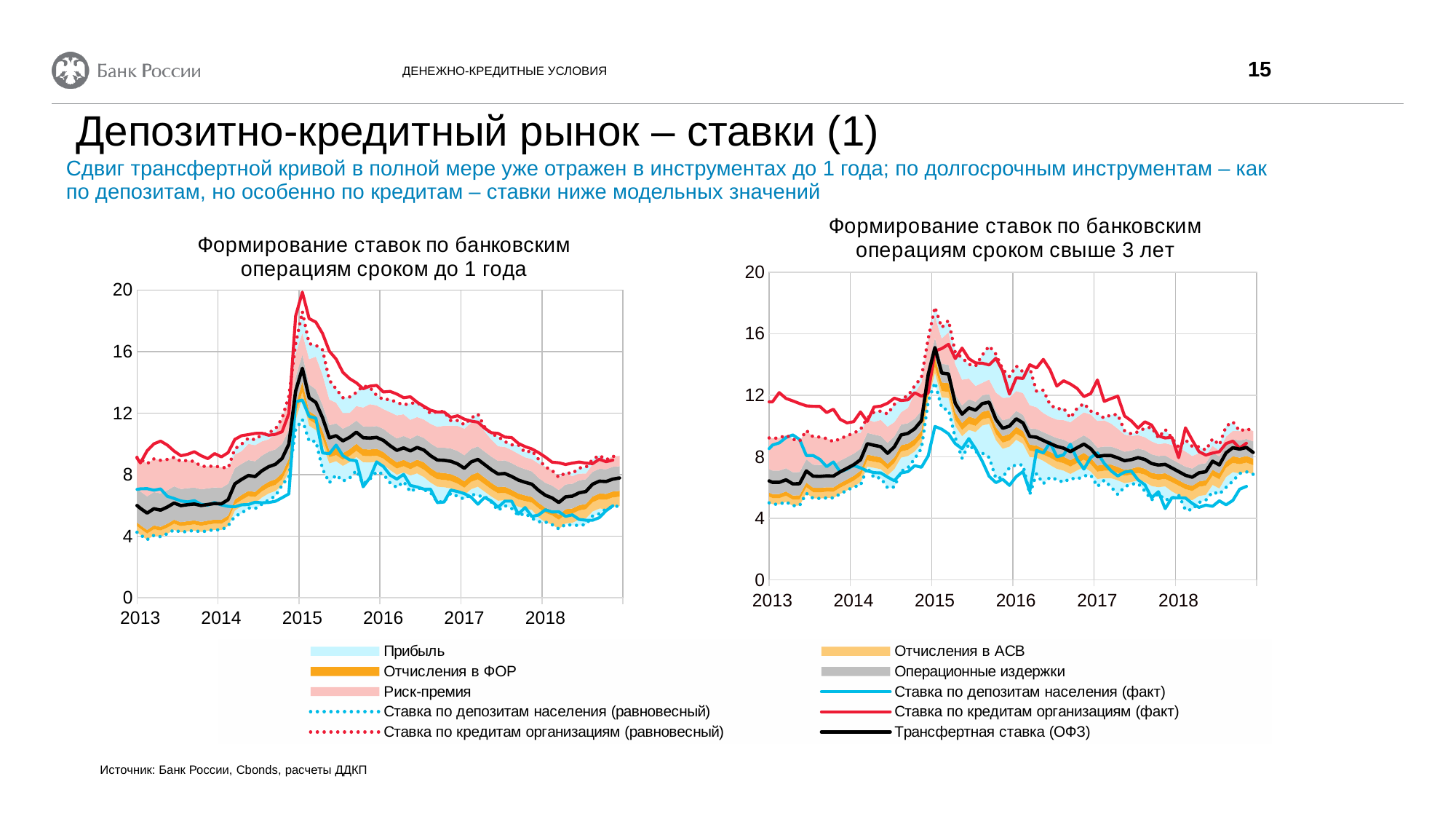
What is the maximum value shown on the y axis of the right chart (свыше 3 лет)? 20 In the left chart (до 1 года), is the blue 'Ставка по депозитам населения (факт)' line at the start of 2013 greater or less than 8? less In the right chart (свыше 3 лет), is the blue 'Ставка по депозитам населения (факт)' line at the end of 2018 greater or less than 8? less In the right chart (свыше 3 лет), is the red 'Ставка по кредитам организациям (факт)' line at the start of 2013 greater or less than 8? greater How many entries does the shared legend below the charts list? 10 In the right chart (свыше 3 лет), does the red 'Ставка по кредитам организациям (факт)' line rise or fall from its 2015 peak to 2018? fall How many year labels are shown on the x axis of the left chart (до 1 года)? 6 In the left chart (до 1 года), in which year does the red 'Ставка по кредитам организациям (факт)' line reach its highest value? 2015 What is the title of the right chart? Формирование ставок по банковским операциям сроком свыше 3 лет In the left chart (до 1 года), which is higher at the 2015 peak: the red 'Ставка по кредитам организациям (факт)' line or the black 'Трансфертная ставка (ОФЗ)' line? Ставка по кредитам организациям (факт) What kind of chart is the left chart, 'Формирование ставок по банковским операциям сроком до 1 года'? Line chart with stacked area bands